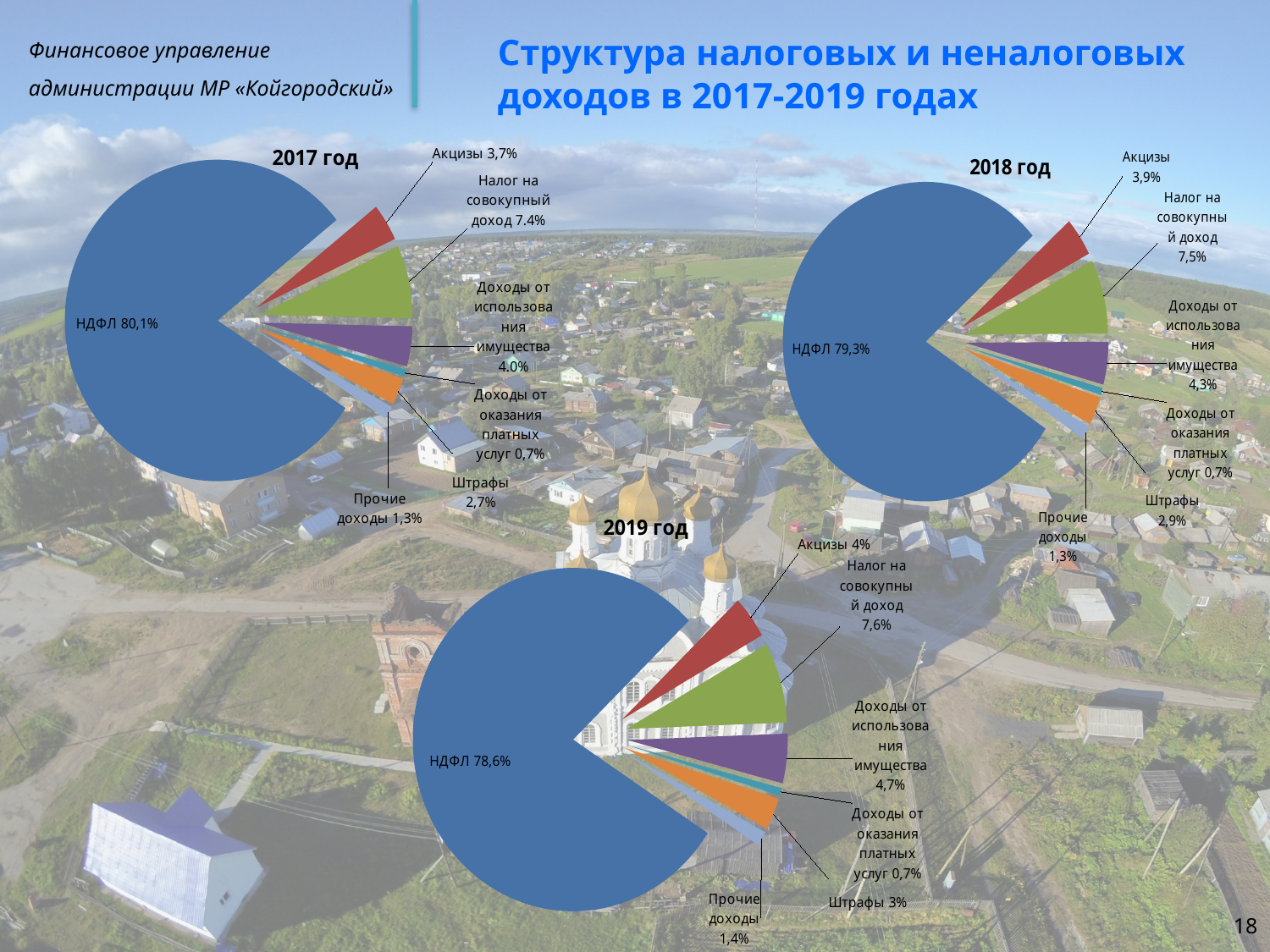
In the 2018 год chart, what is the value for Акцизы? 3,9% In the 2018 год chart, which category has the largest share? НДФЛ In the 2019 год chart, what is the value for Налог на совокупный доход? 7,6% In the 2017 год chart, which category has the smallest share? Доходы от оказания платных услуг What type of chart is used for the 2017 год data? Pie chart How many categories are shown in the 2019 год chart? 7 In the 2019 год chart, what is the value for Доходы от использования имущества? 4,7% How many pie charts are on the slide? 3 In the 2019 год chart, which is larger: Штрафы or Прочие доходы? Штрафы In the 2017 год chart, what share does НДФЛ have? 80,1% In the 2018 год chart, what is the difference between Налог на совокупный доход and Доходы от использования имущества? 3,2% What is the difference between the НДФЛ share in the 2017 год chart and in the 2019 год chart? 1,5%